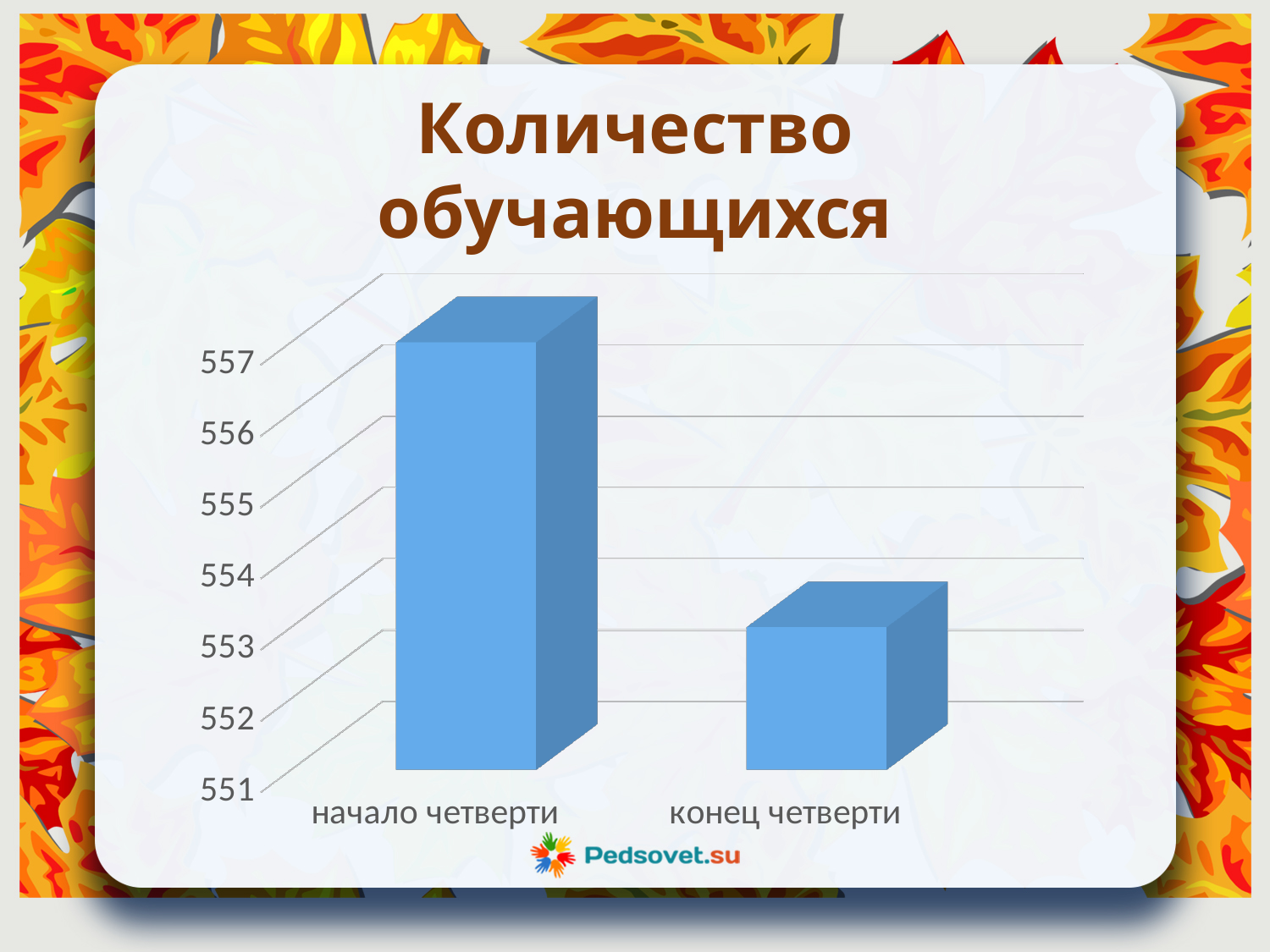
What is the lowest value shown on the vertical axis? 551 Which category has the highest value? начало четверти Is the value for конец четверти greater or less than 552? greater Which is larger, the value for начало четверти or the value for конец четверти? начало четверти What type of chart is shown on the slide? bar chart Is the value for конец четверти greater or less than 555? less Do the values rise or fall from начало четверти to конец четверти? fall Which category has the lowest value? конец четверти What is the title of the chart? Количество обучающихся How many categories are plotted in the chart? 2 Is the value for начало четверти greater or less than 555? greater